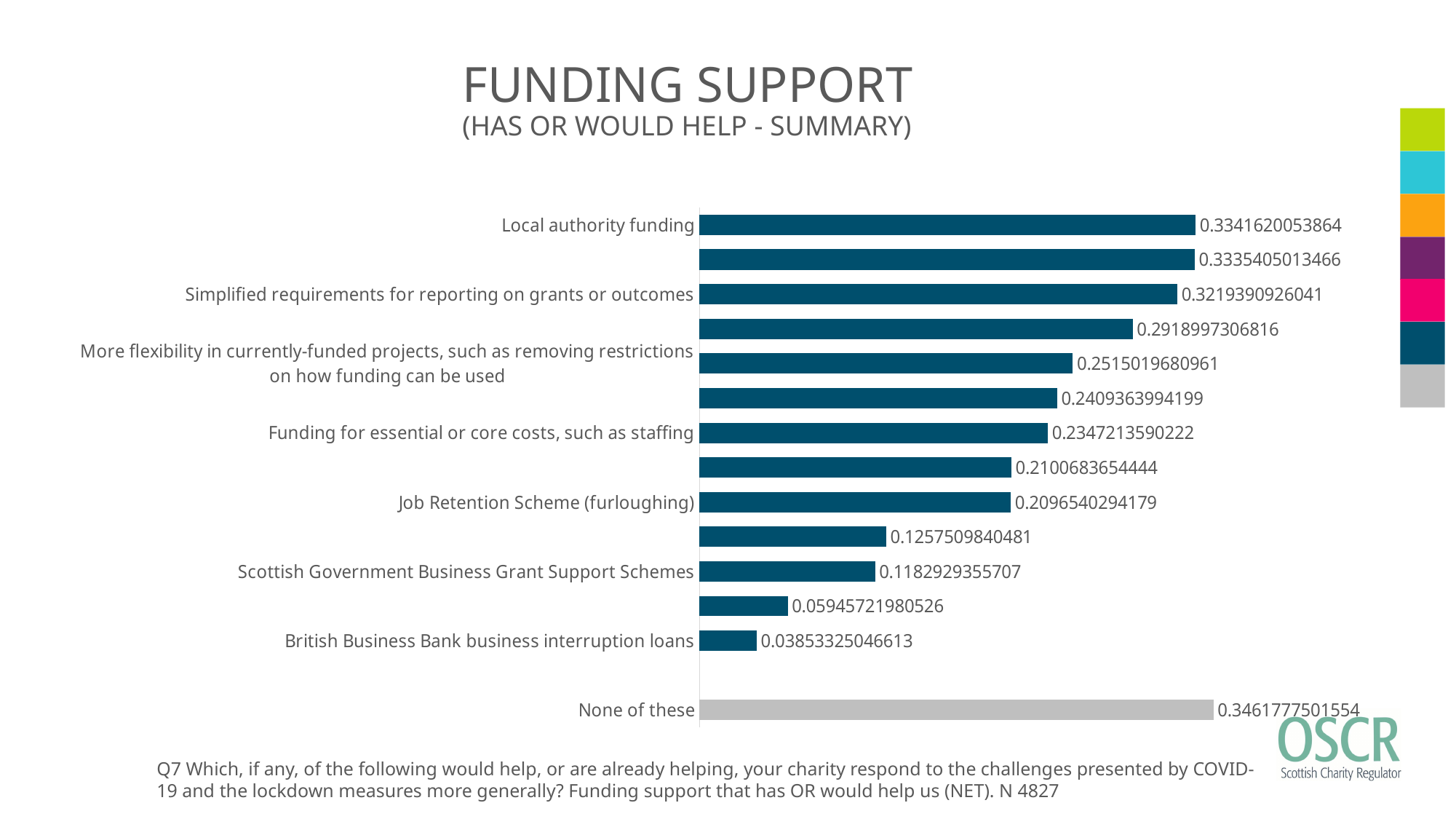
What is the value for Job Retention Scheme (furloughing)? 0.2096540294179 What colour is the bar for None of these? Grey Which category has the lowest value? British Business Bank business interruption loans What is the value for Scottish Government Business Grant Support Schemes? 0.1182929355707 What is the difference between the values for Local authority funding and Simplified requirements for reporting on grants or outcomes? 0.0122229127823 What kind of chart is shown on the slide? Bar chart What is the value for None of these? 0.3461777501554 How many bars are plotted in the chart? 14 What is the value for Local authority funding? 0.3341620053864 Which is larger: the value for Job Retention Scheme (furloughing) or the value for Scottish Government Business Grant Support Schemes? Job Retention Scheme (furloughing) Which category has the highest value? None of these What is the value for British Business Bank business interruption loans? 0.03853325046613